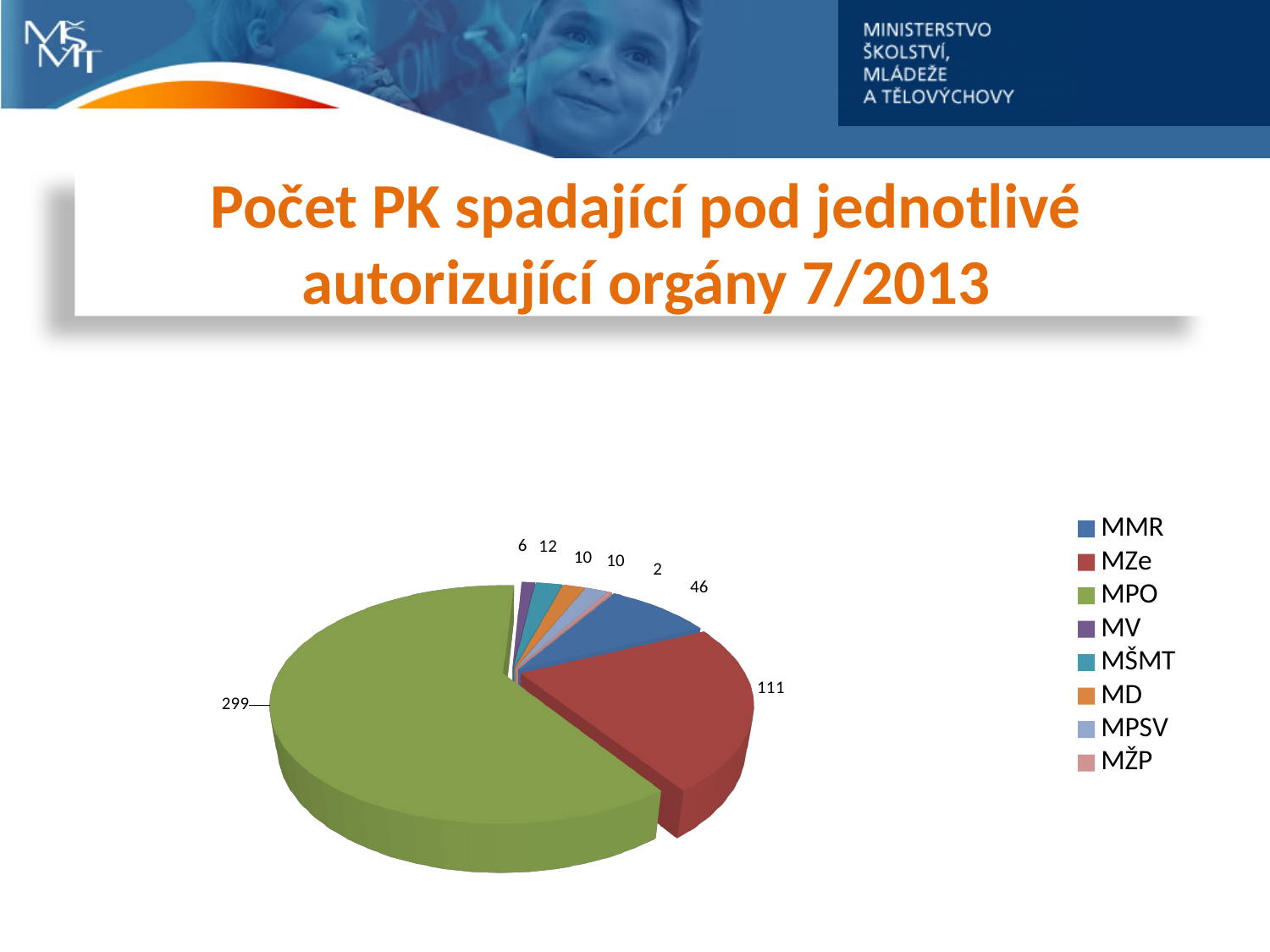
Which category has the smallest slice of the pie? MŽP What is the title of the slide containing the chart? Počet PK spadající pod jednotlivé autorizující orgány 7/2013 What is the value for MZe? 111 Which is larger, the value for MMR or the value for MŠMT? MMR How many categories does the pie chart show? 8 What is the difference between the values for MPO and MZe? 188 What is the value for MŽP? 2 What type of chart is shown on the slide? pie chart Which category has the largest slice of the pie? MPO What is the value for MMR? 46 What is the value for MPO? 299 What is the value for MŠMT? 12